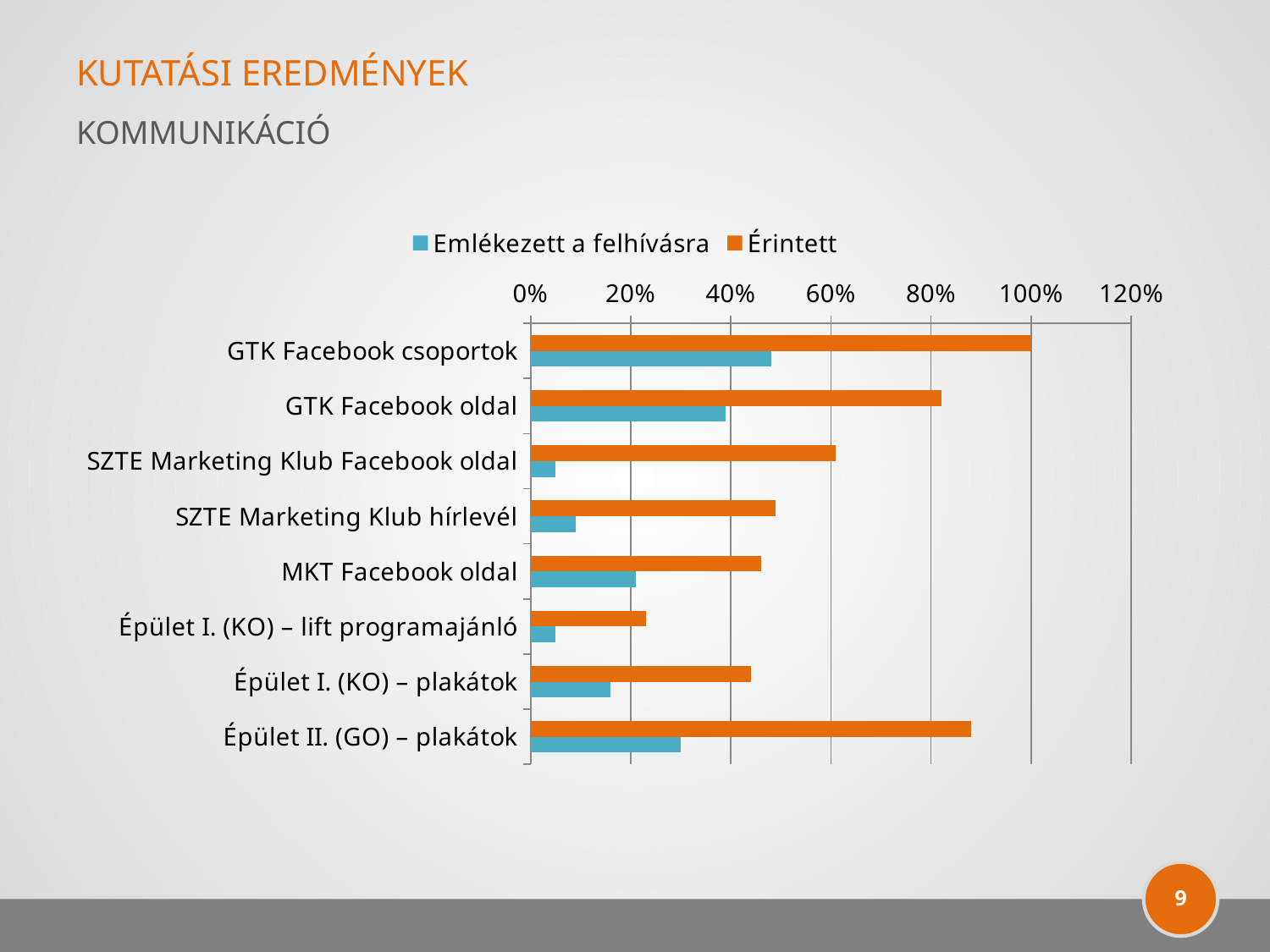
Is the Emlékezett a felhívásra value for SZTE Marketing Klub hírlevél greater or less than 20%? less Which colour represents the Érintett series in the legend? orange Which category has the lowest Érintett value? Épület I. (KO) – lift programajánló Is the Emlékezett a felhívásra value for Épület II. (GO) – plakátok greater or less than 20%? greater Which category has the highest Emlékezett a felhívásra value? GTK Facebook csoportok Which has the larger Érintett value: Épület II. (GO) – plakátok or Épület I. (KO) – plakátok? Épület II. (GO) – plakátok Is the Érintett value for GTK Facebook oldal greater or less than 80%? greater What is the Érintett value for GTK Facebook csoportok? 100% How many series does the legend list? 2 How many categories are shown on the chart? 8 What kind of chart is shown on the slide? bar chart Which category has the highest Érintett value? GTK Facebook csoportok